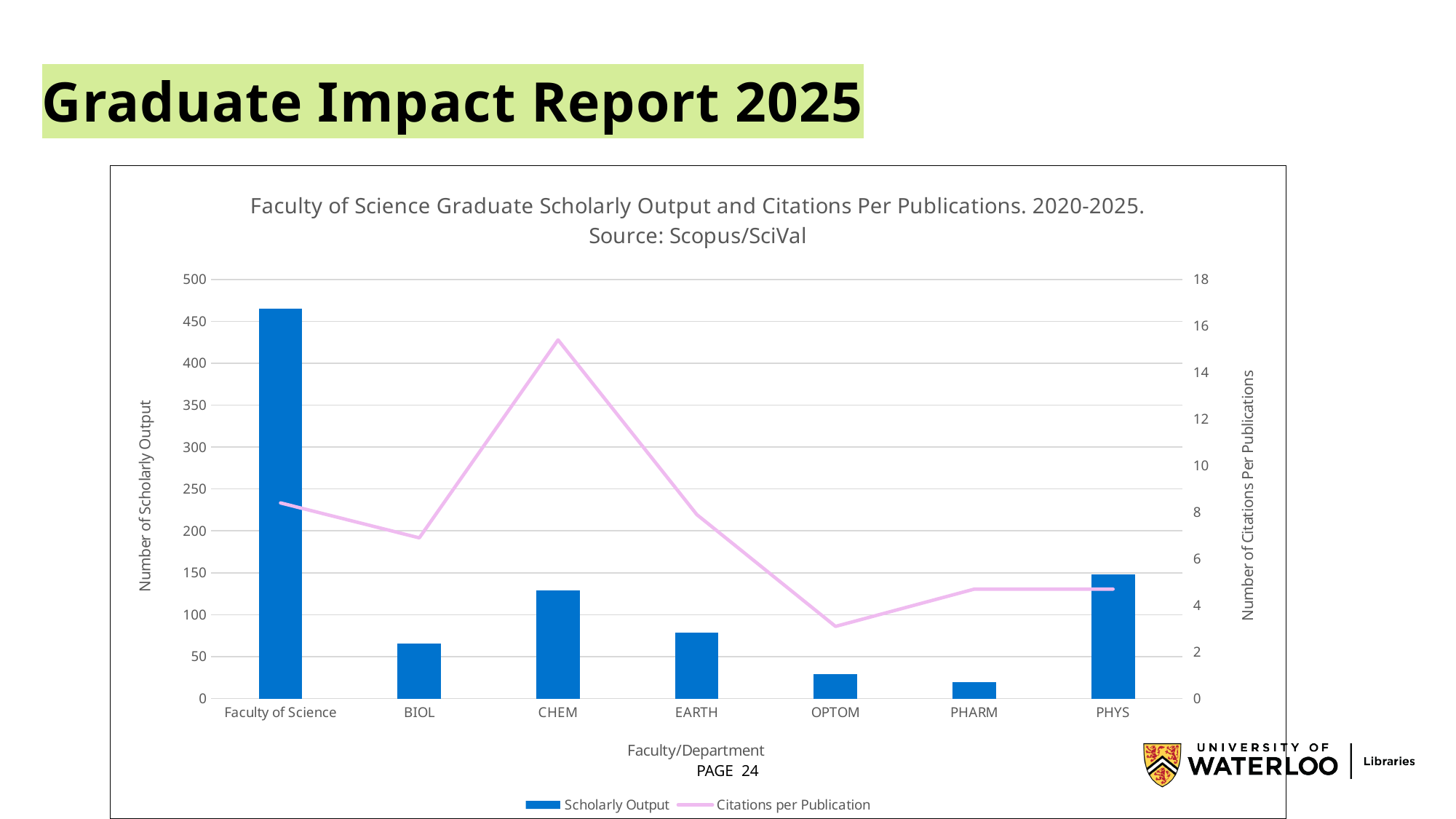
How many categories are shown on the x axis? 7 Which has the larger Scholarly Output, PHYS or CHEM? PHYS Which category has the lowest Scholarly Output? PHARM What is the source named in the chart title? Scopus/SciVal Which category has the lowest Citations per Publication? OPTOM Is the Scholarly Output for CHEM greater or less than 100? greater Is the Citations per Publication value for CHEM greater or less than 14? greater What kind of chart is shown on the slide? A combined bar and line chart Is the Scholarly Output for Faculty of Science greater or less than 450? greater Which category has the highest Citations per Publication? CHEM Which category has the highest Scholarly Output? Faculty of Science How many series does the legend list? 2